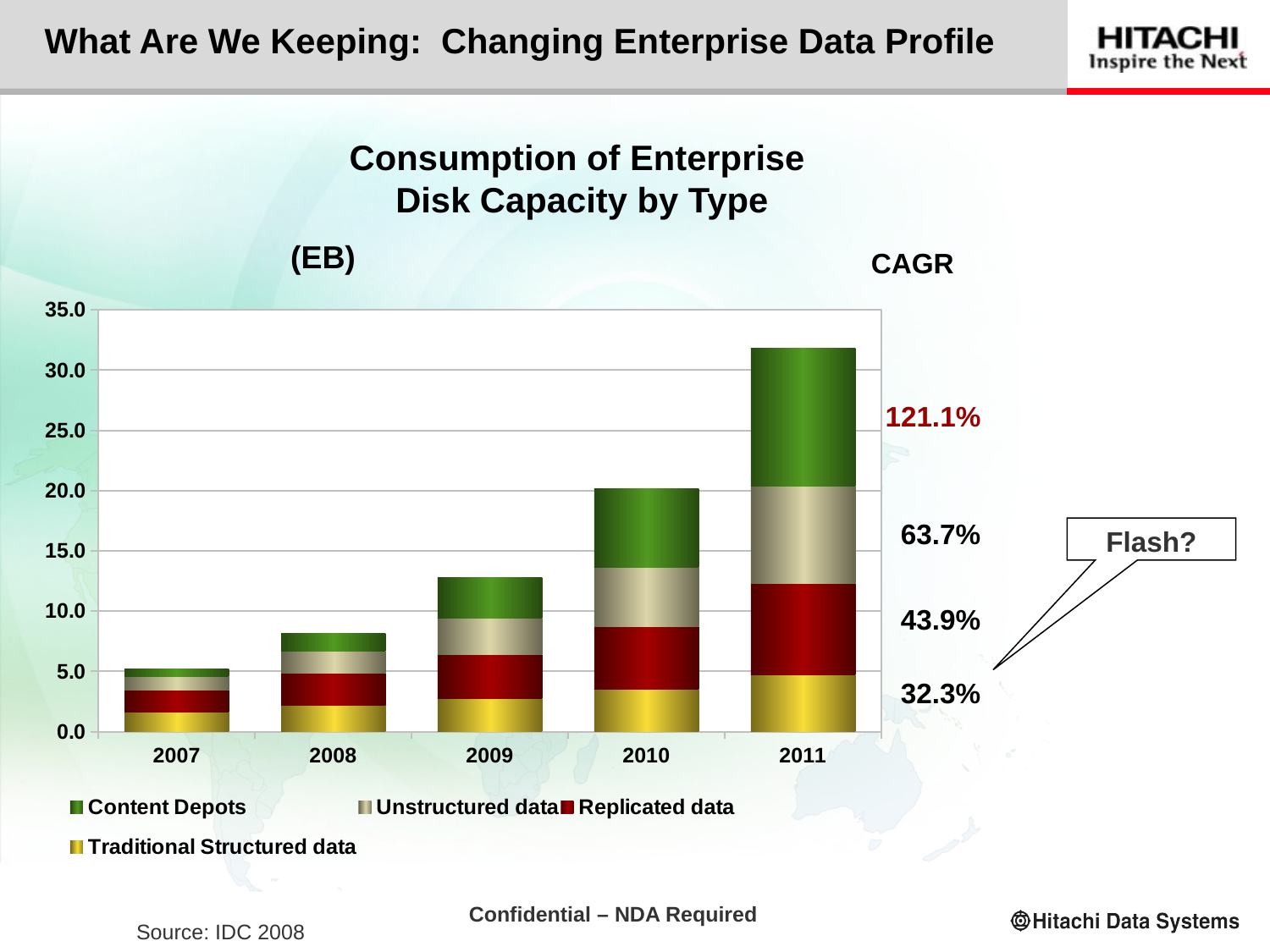
Which year has the shortest stacked bar? 2007 Is the total bar height for 2007 greater or less than 10.0? less Which year has the tallest stacked bar? 2011 What kind of chart is shown on the slide? Stacked bar chart How many years are shown on the x axis of the chart? 5 How many data series does the chart legend list? 4 What is the highest CAGR value printed next to the chart? 121.1% Is the total bar height for 2011 greater or less than 30.0? greater Which year has the larger total bar, 2009 or 2010? 2010 Is the total bar height for 2009 greater or less than 10.0? greater Which series is shown in green in the chart legend? Content Depots Do the total bar heights rise or fall from 2007 to 2011? Rise